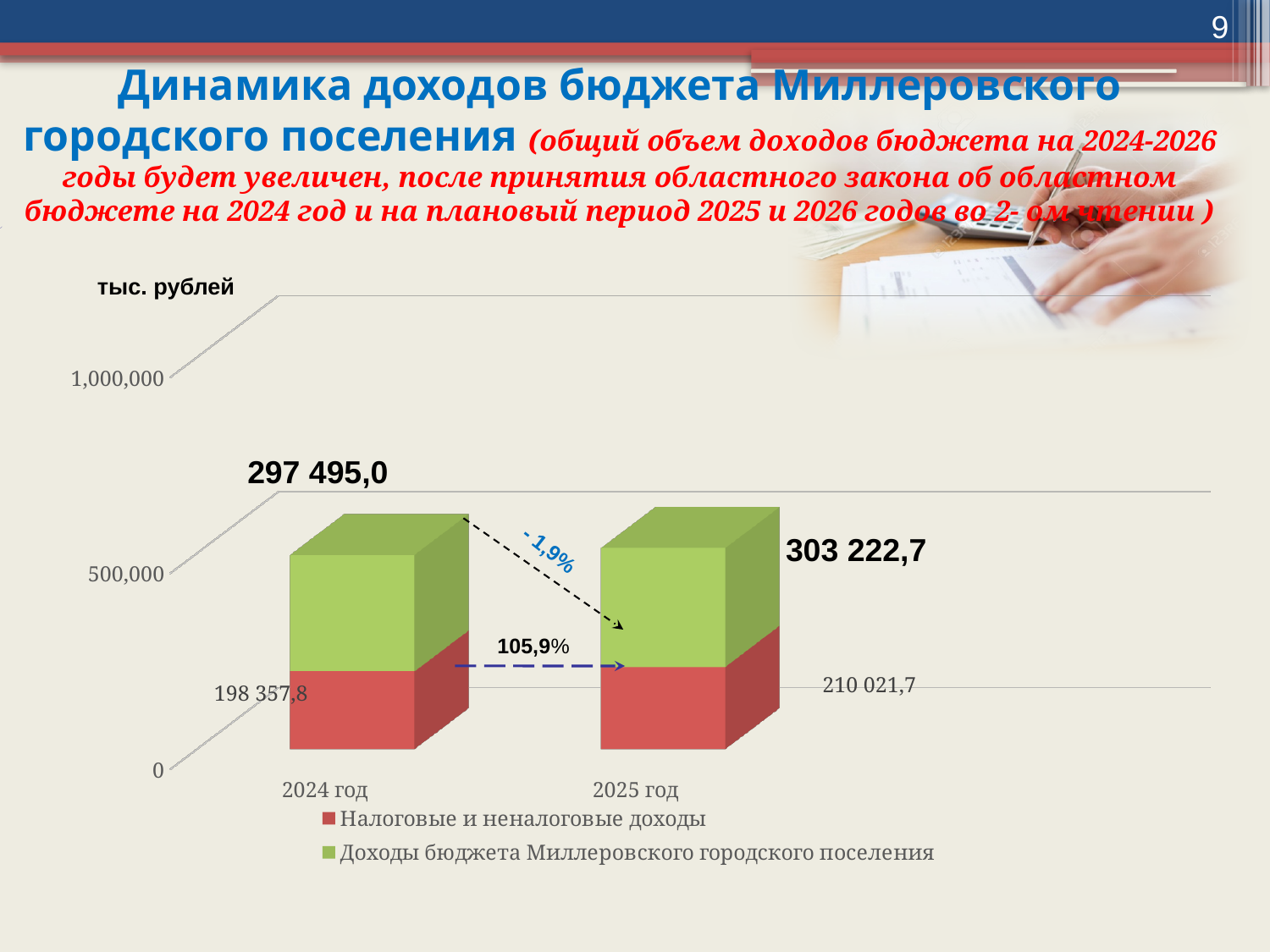
What is the difference between the Доходы бюджета Миллеровского городского поселения values for 2025 год and 2024 год? 5 727,7 Do the values for Налоговые и неналоговые доходы rise or fall from 2024 год to 2025 год? Rise What is the value of Доходы бюджета Миллеровского городского поселения for 2024 год? 297 495,0 How many year categories are shown on the x axis of the chart? 2 What kind of chart is shown on the slide? Stacked bar chart Which year has the higher value for Налоговые и неналоговые доходы, 2024 год or 2025 год? 2025 год How many series does the chart legend list? 2 What unit is indicated above the vertical axis of the chart? тыс. рублей What is the value of Налоговые и неналоговые доходы for 2024 год? 198 357,8 What is the difference between the Налоговые и неналоговые доходы values for 2025 год and 2024 год? 11 663,9 What is the value of Налоговые и неналоговые доходы for 2025 год? 210 021,7 What is the value of Доходы бюджета Миллеровского городского поселения for 2025 год? 303 222,7